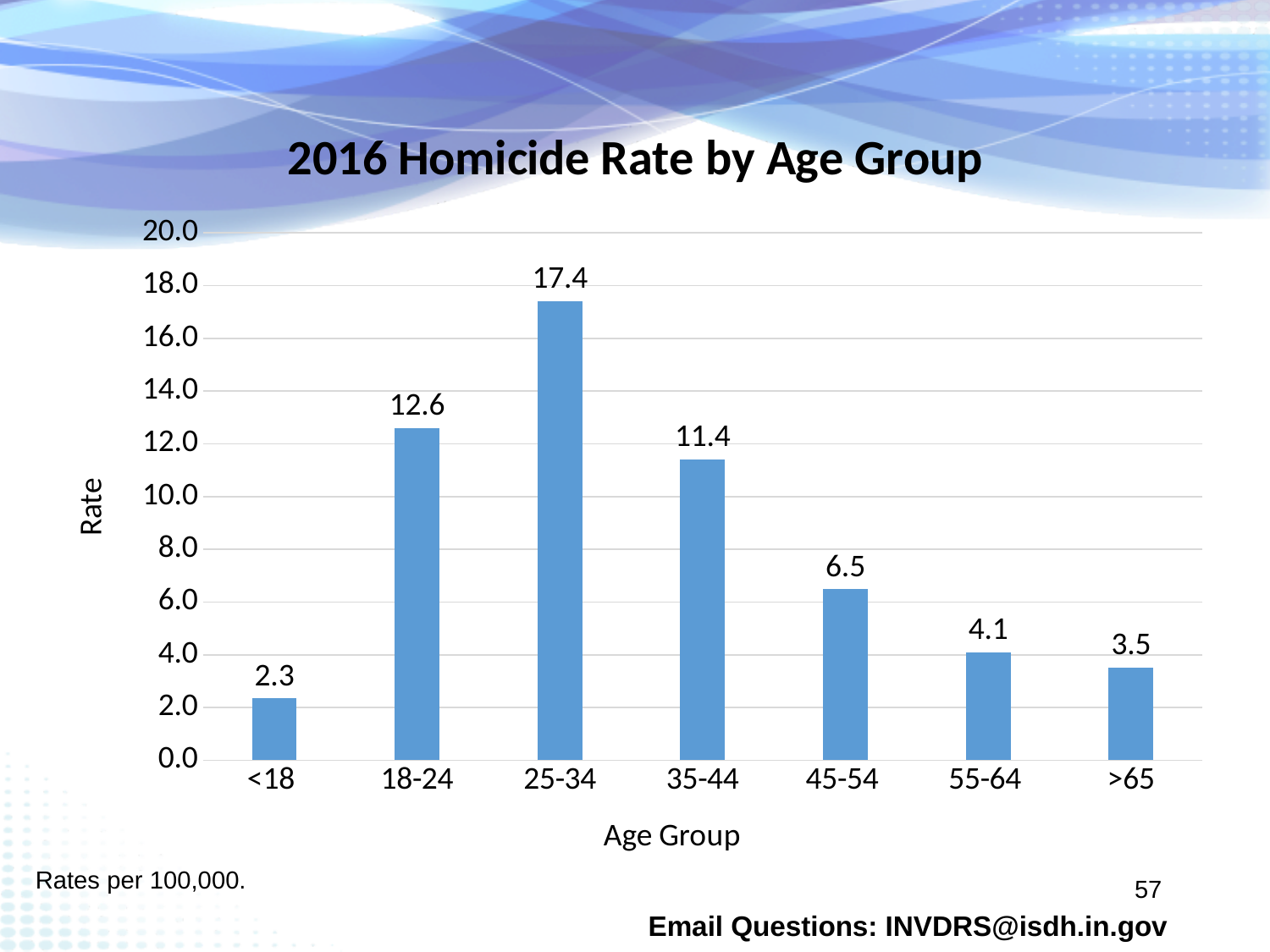
Is the homicide rate for the 35-44 age group greater or less than 10.0? greater What is the title of the chart? 2016 Homicide Rate by Age Group Which age group has the lowest homicide rate? <18 What is the homicide rate for the <18 age group? 2.3 Which age group has the highest homicide rate? 25-34 Which age group has a higher homicide rate, 18-24 or 35-44? 18-24 What is the homicide rate for the 25-34 age group? 17.4 How many age groups are shown in the chart? 7 What is the homicide rate for the 45-54 age group? 6.5 What type of chart is shown on the slide? Bar chart What is the difference between the homicide rates for the 25-34 and 18-24 age groups? 4.8 What is the difference between the homicide rates for the 55-64 and >65 age groups? 0.6